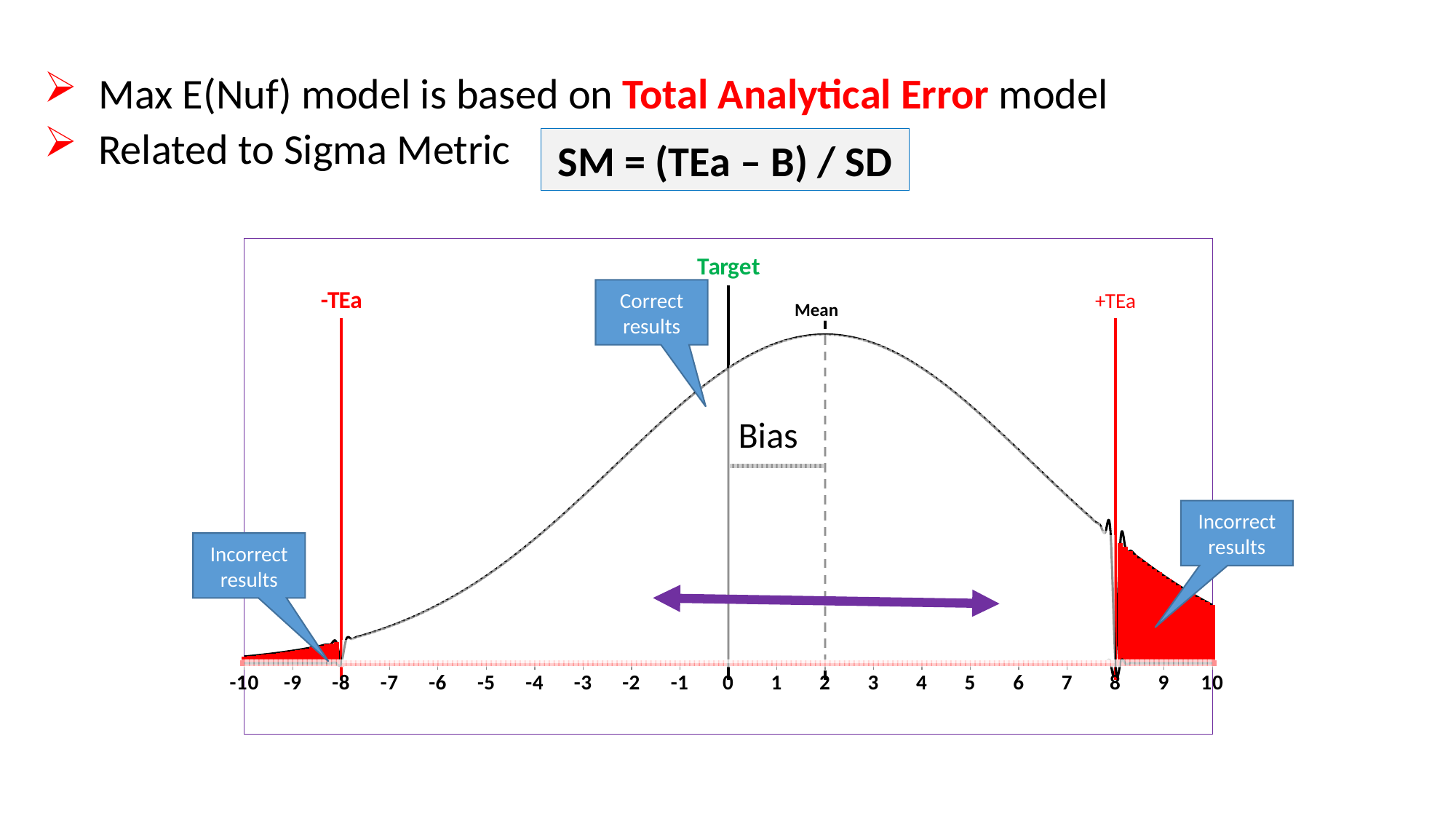
At what x-axis value is the Mean line drawn? 2 At what x-axis value is the +TEa line drawn? 8 What are the minimum and maximum values labelled on the x axis? -10 and 10 What kind of chart is shown on the slide? Line chart What colour are the shaded areas labelled 'Incorrect results'? Red At what x-axis value is the -TEa line drawn? -8 Which is positioned further to the right on the x axis, the Mean line or the Target line? Mean What is the distance on the x axis between the -TEa line and the +TEa line? 16 At what x-axis value does the curve reach its peak? 2 At what x-axis value is the Target line drawn? 0 How many tick labels are shown on the x axis? 21 What is the difference on the x axis between the Mean line and the Target line (the Bias)? 2